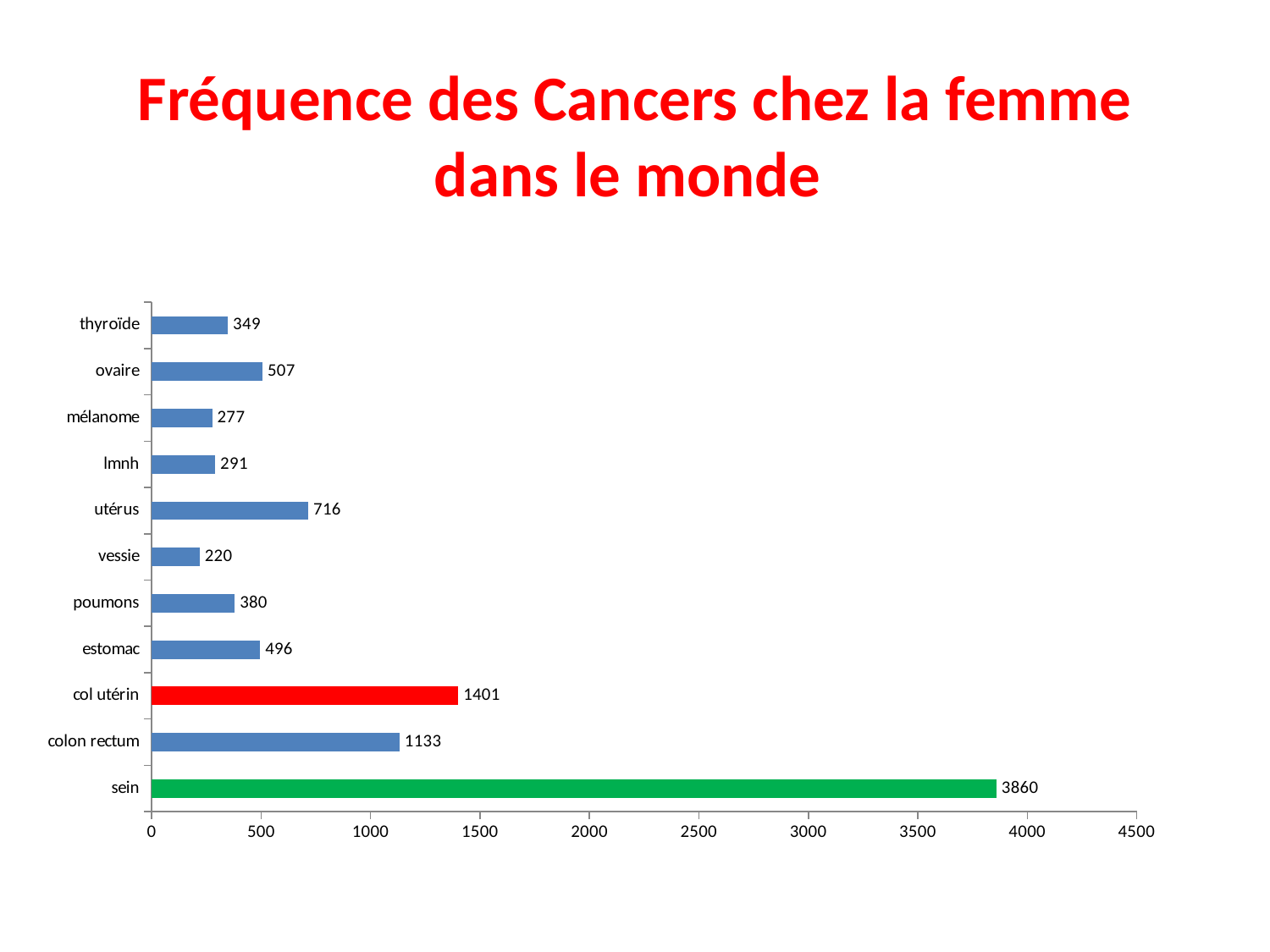
Which category has the lowest value? vessie Which category has the highest value? sein How many categories are shown on the chart? 11 What is the value for col utérin? 1401 What kind of chart is shown on the slide? bar chart Which is larger, the value for ovaire or the value for estomac? ovaire Is the value for colon rectum greater or less than 1000? greater What is the value for utérus? 716 What is the value for sein? 3860 What colour is the bar for sein? green What is the difference between the values for col utérin and colon rectum? 268 What is the title of the slide? Fréquence des Cancers chez la femme dans le monde